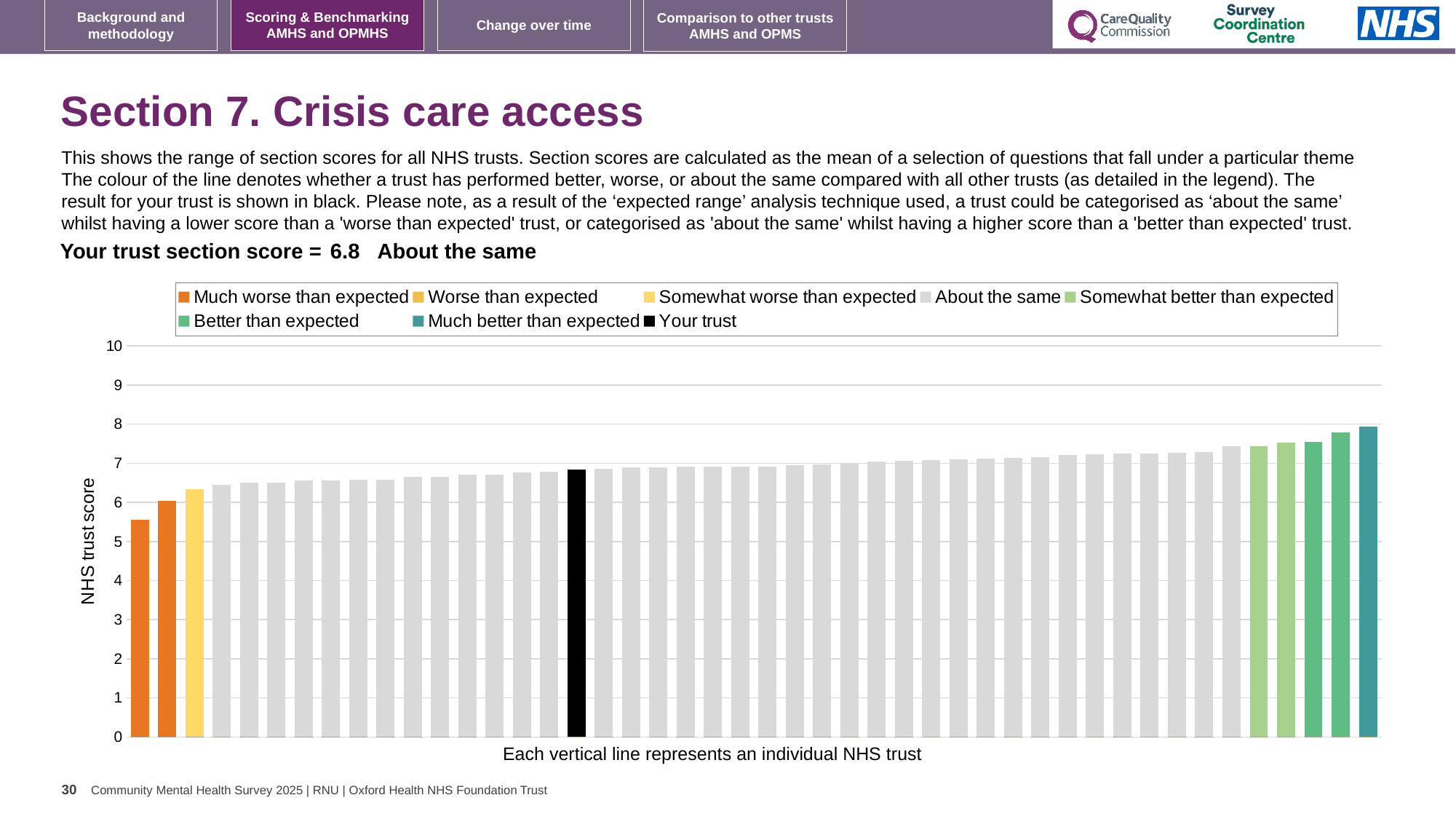
Which performance category is your trust placed in for Section 7? About the same Is the value of the leftmost bar greater or less than 5? greater How many entries does the chart legend list? 8 What is the section score for your trust shown on the slide? 6.8 How many bars are coloured as 'Much better than expected'? 1 Which is larger, the leftmost bar or the rightmost bar? The rightmost bar Do the bar values rise or fall moving from left to right along the x axis? Rise How many bars are coloured as 'Much worse than expected'? 2 What kind of chart is shown on the slide? Bar chart Is the value of the rightmost (highest) bar greater or less than 7? greater What is the label on the vertical axis of the chart? NHS trust score Is the value of the leftmost (lowest) bar greater or less than 6? less